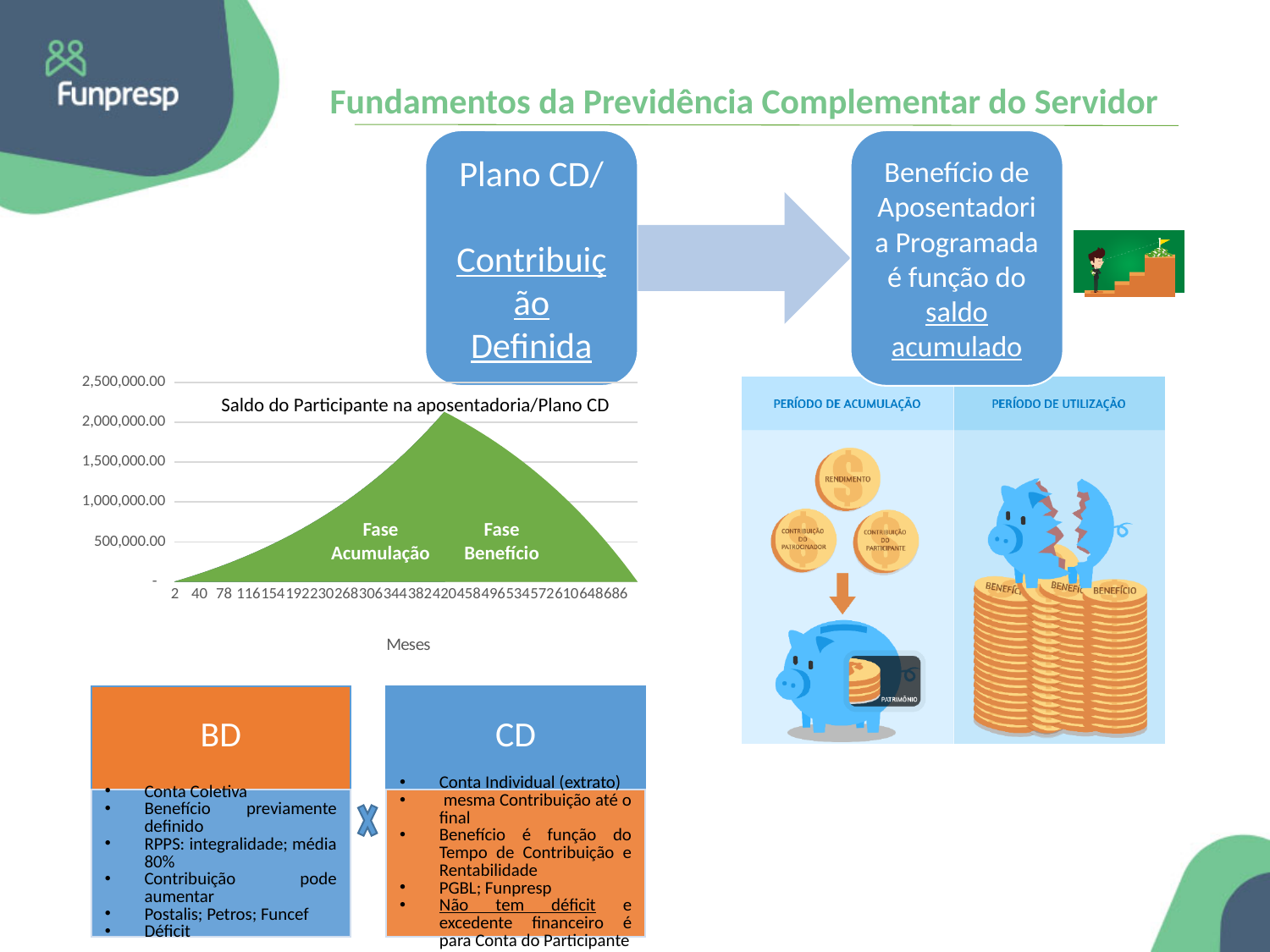
What is the label of the x axis of the chart? Meses How do the values change along the x axis of the chart? rise then fall What is the highest tick value shown on the y axis of the chart? 2,500,000.00 What kind of chart is shown on the slide? area chart Is the peak value of the chart greater or less than 2,500,000.00? less What is the last tick value shown on the x axis of the chart? 686 Is the peak value of the chart greater or less than 1,500,000.00? greater Does the value at month 686 rise or fall compared with the value at month 344? fall What is the first tick value shown on the x axis of the chart? 2 Is the value at month 2 greater or less than 500,000.00? less What is the title of the chart? Saldo do Participante na aposentadoria/Plano CD